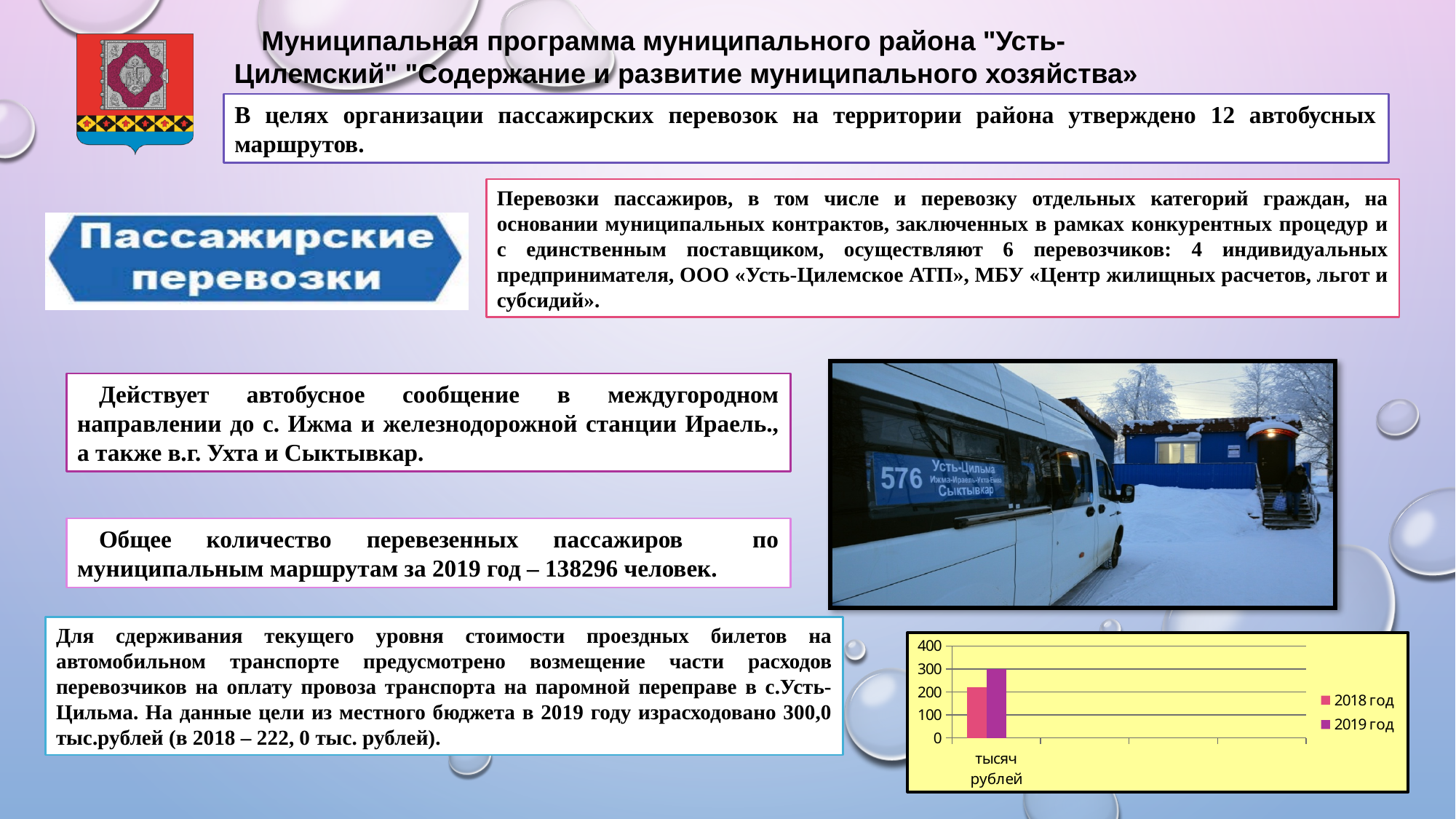
In the bar chart, which series has the taller bar, 2018 год or 2019 год? 2019 год What are the two series named in the legend of the bar chart? 2018 год and 2019 год Is the value for 2018 год in the bar chart greater or less than 300? less In the bar chart, which series has the lowest value? 2018 год What is the category label on the x axis of the bar chart? тысяч рублей Is the value for 2018 год in the bar chart greater or less than 200? greater Is the value for 2019 год in the bar chart greater or less than 200? greater How many categories are shown on the x axis of the bar chart? 1 What kind of chart is shown at the bottom right of the slide? bar chart In the bar chart, which series has the highest value? 2019 год How many series does the legend of the bar chart list? 2